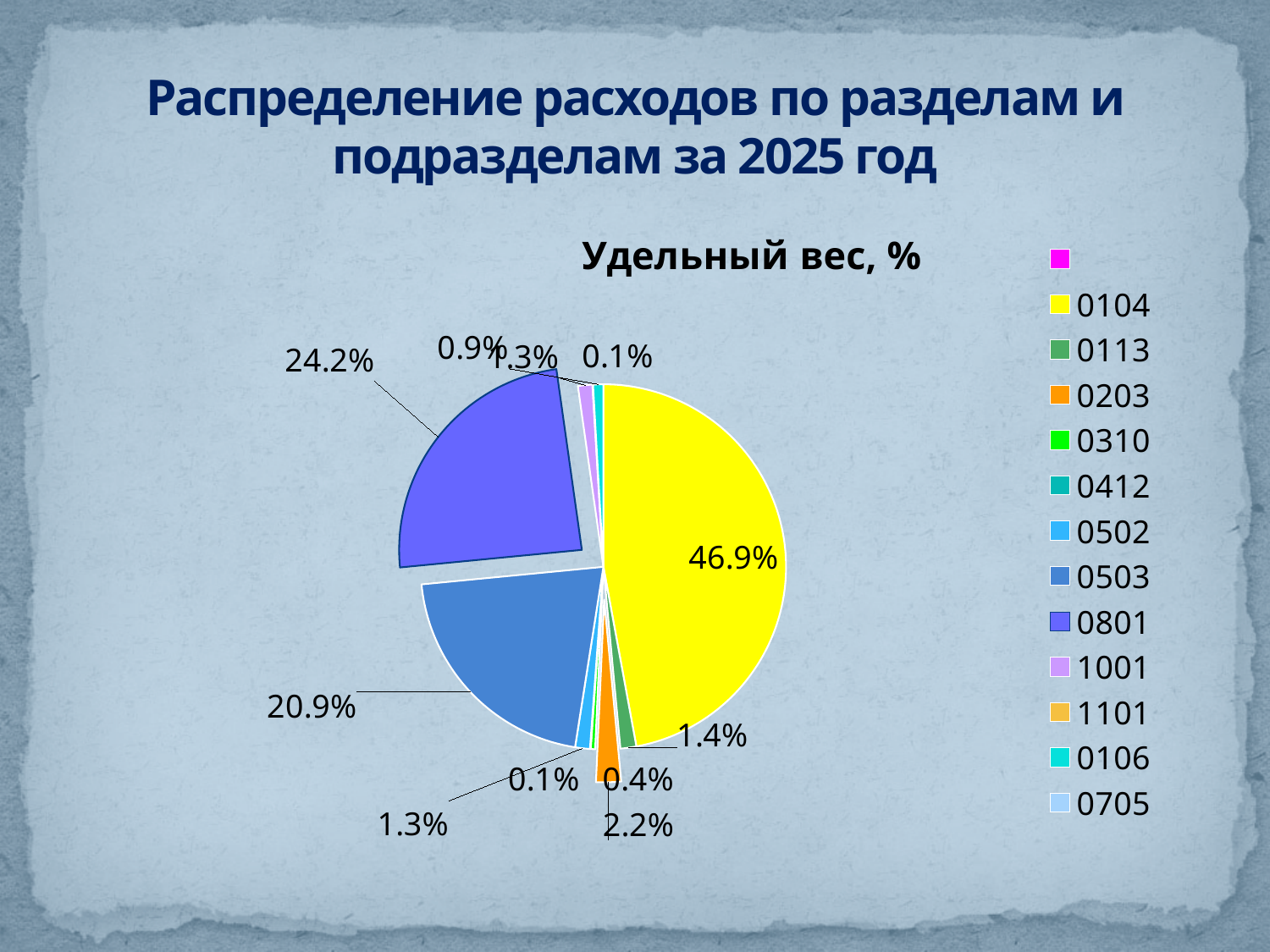
Which is larger, the slice for 0801 or the slice for 0503? 0801 What is the value shown for category 0113? 1.4% What is the difference between the values for 0104 and 0801? 22.7% What is the value shown for category 0503? 20.9% What is the value shown for category 0801? 24.2% What is the title of the chart? Удельный вес, % What is the combined share of the three largest slices (0104, 0801 and 0503)? 92.0% What is the value shown for category 0203? 2.2% What share of the pie does category 0104 have? 46.9% What is the difference between the values for 0801 and 0503? 3.3% What kind of chart is shown on the slide? pie chart Which category has the largest slice of the pie? 0104